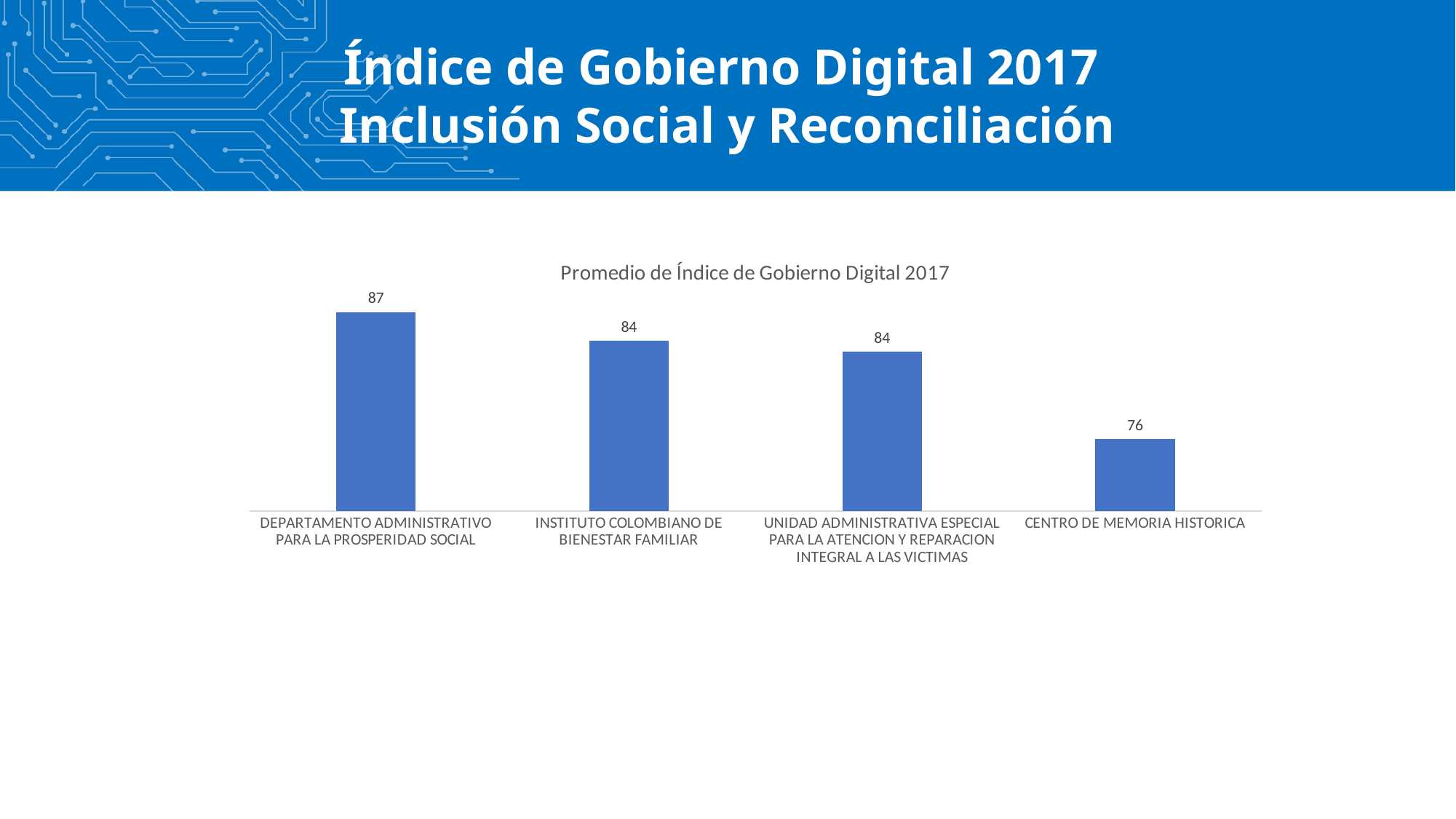
What kind of chart is shown on the slide? Bar chart What is the difference between the values for DEPARTAMENTO ADMINISTRATIVO PARA LA PROSPERIDAD SOCIAL and CENTRO DE MEMORIA HISTORICA? 11 What is the value for DEPARTAMENTO ADMINISTRATIVO PARA LA PROSPERIDAD SOCIAL? 87 What is the value for UNIDAD ADMINISTRATIVA ESPECIAL PARA LA ATENCION Y REPARACION INTEGRAL A LAS VICTIMAS? 84 How many categories are shown in the chart? 4 Which category has the lowest value? CENTRO DE MEMORIA HISTORICA Which is larger, the value for DEPARTAMENTO ADMINISTRATIVO PARA LA PROSPERIDAD SOCIAL or the value for INSTITUTO COLOMBIANO DE BIENESTAR FAMILIAR? DEPARTAMENTO ADMINISTRATIVO PARA LA PROSPERIDAD SOCIAL Which category has the highest value? DEPARTAMENTO ADMINISTRATIVO PARA LA PROSPERIDAD SOCIAL What is the title of the chart? Promedio de Índice de Gobierno Digital 2017 What is the value for CENTRO DE MEMORIA HISTORICA? 76 What is the value for INSTITUTO COLOMBIANO DE BIENESTAR FAMILIAR? 84 What is the difference between the values for INSTITUTO COLOMBIANO DE BIENESTAR FAMILIAR and CENTRO DE MEMORIA HISTORICA? 8